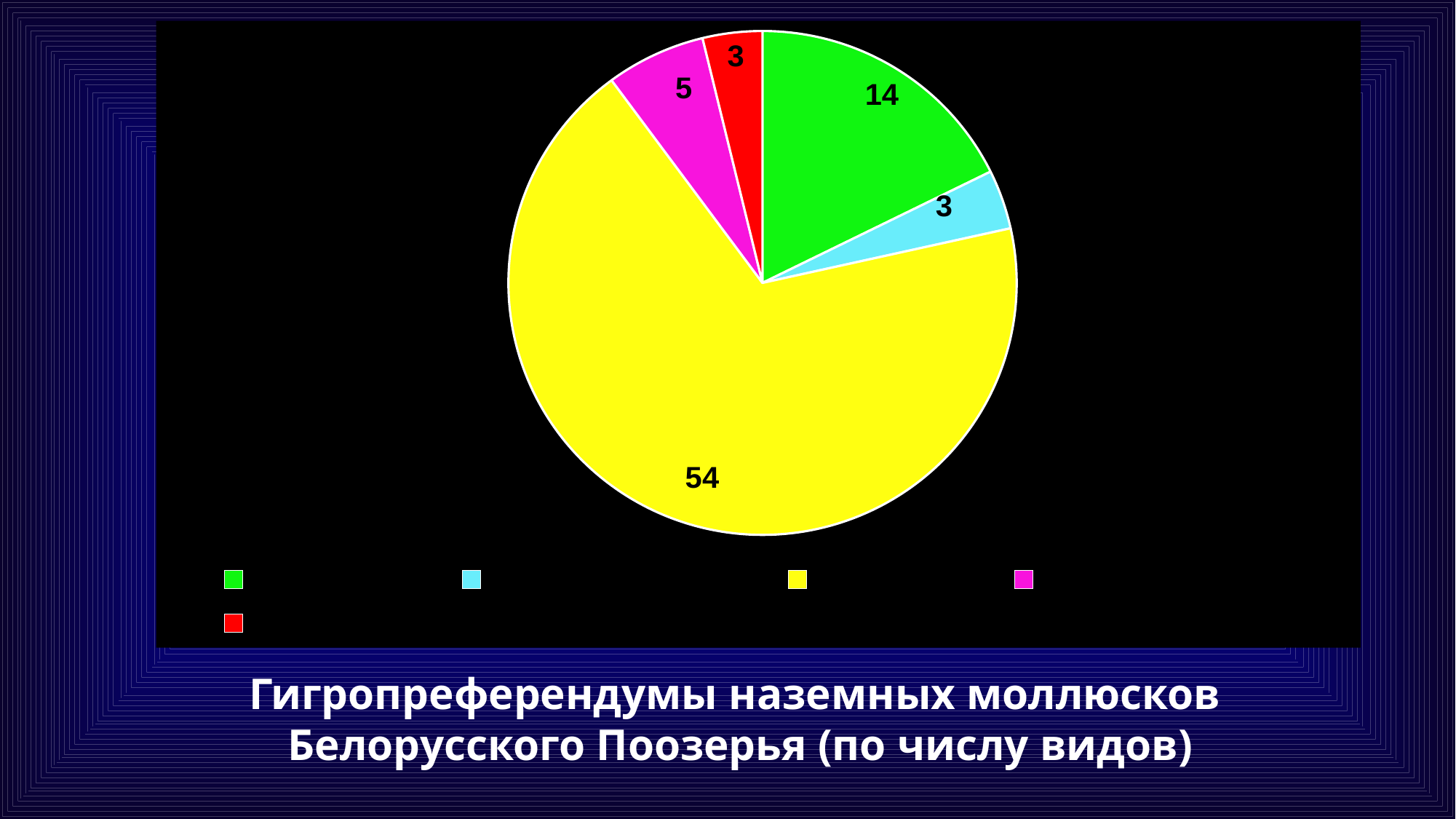
What kind of chart is shown on the slide? pie chart Which colour slice has the largest value in the pie chart? yellow What is the smallest value shown on any slice of the pie chart? 3 What value is shown on the green slice of the pie chart? 14 How many slices does the pie chart have? 5 Which is larger, the green slice value or the magenta slice value? green How many entries does the legend of the pie chart list? 5 What value is shown on the yellow slice of the pie chart? 54 What value is shown on the cyan slice of the pie chart? 3 What value is shown on the magenta slice of the pie chart? 5 What is the difference between the yellow slice value and the green slice value? 40 What is the total of all the slice values in the pie chart? 79